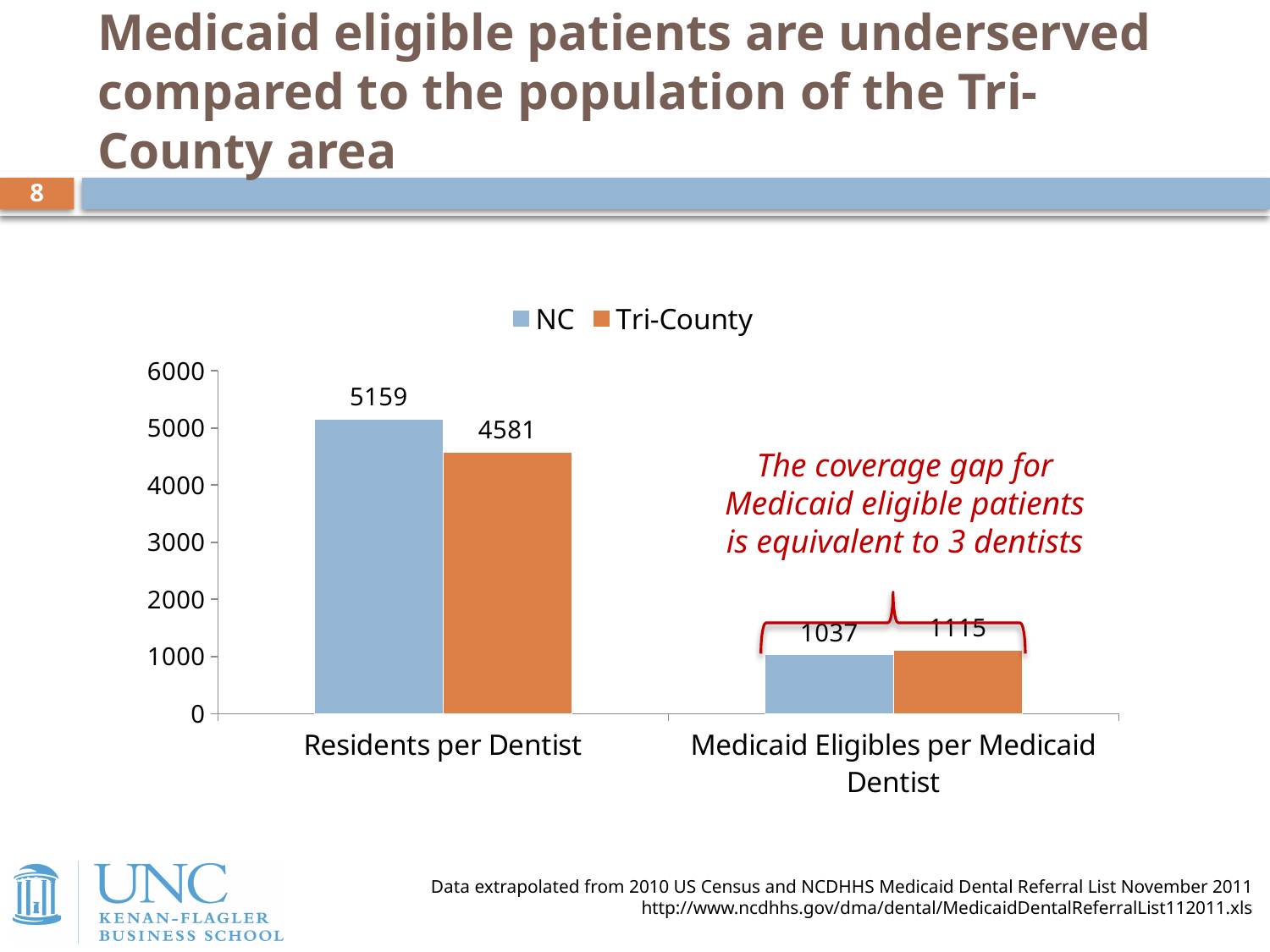
What is the Tri-County value for Residents per Dentist? 4581 What is the Tri-County value for Medicaid Eligibles per Medicaid Dentist? 1115 Which series has the higher value for Medicaid Eligibles per Medicaid Dentist, NC or Tri-County? Tri-County What type of chart is shown on the slide? Bar chart How many categories are shown on the x axis? 2 What is the difference between the Tri-County and NC values for Medicaid Eligibles per Medicaid Dentist? 78 How many series does the legend list? 2 What is the NC value for Medicaid Eligibles per Medicaid Dentist? 1037 What is the difference between the NC and Tri-County values for Residents per Dentist? 578 Which series has the higher value for Residents per Dentist, NC or Tri-County? NC Which bar has the highest value in the chart? NC, Residents per Dentist What is the NC value for Residents per Dentist? 5159